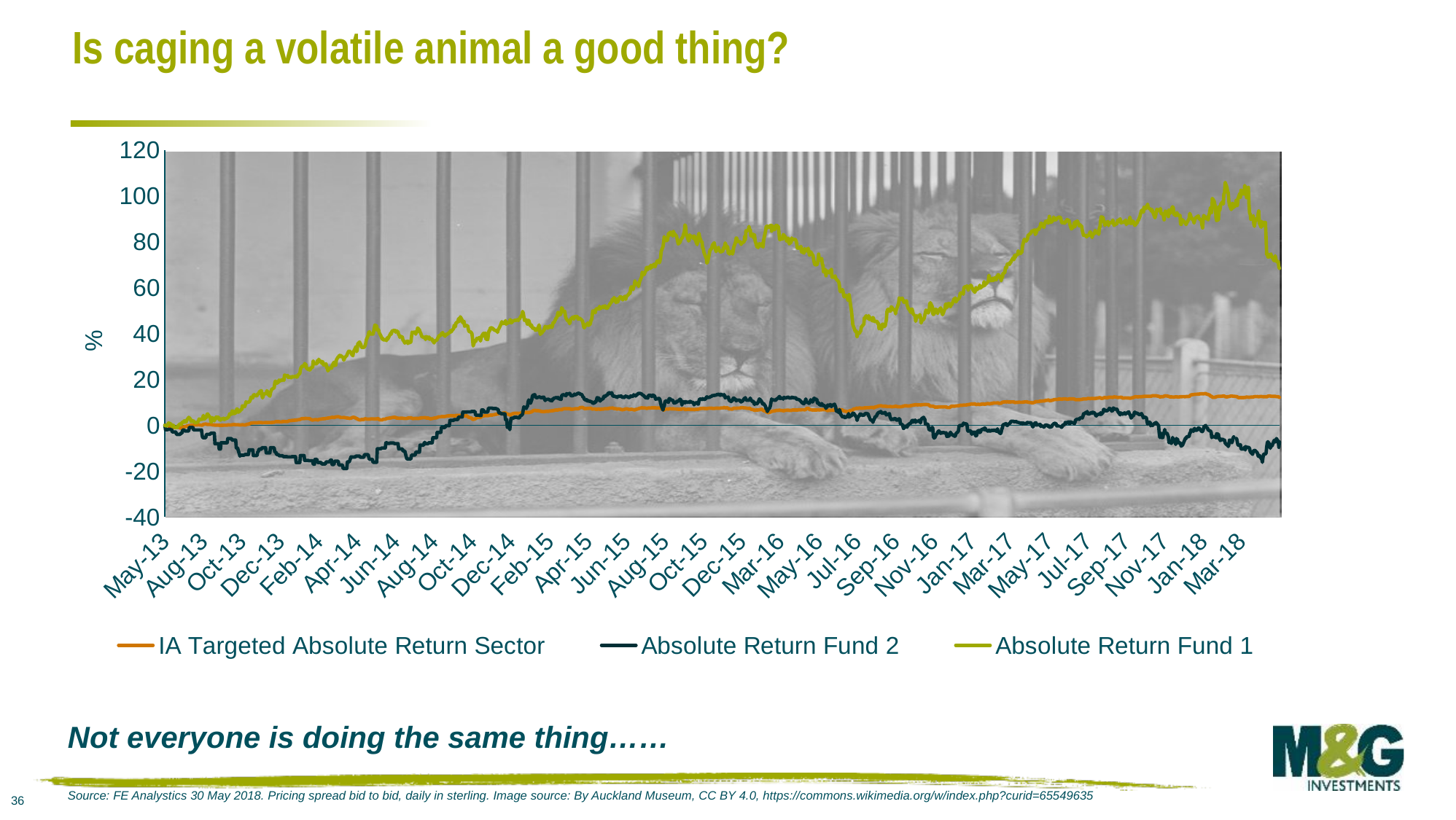
Is the value for Absolute Return Fund 1 around Jul-16 greater or less than 80? less Is the value for IA Targeted Absolute Return Sector at Mar-18 greater or less than 20? less At Mar-18, which is higher: Absolute Return Fund 1 or Absolute Return Fund 2? Absolute Return Fund 1 Is the highest value reached by Absolute Return Fund 1 greater or less than 80? greater How many series does the chart's legend list? 3 Which series reaches the highest value on the chart? Absolute Return Fund 1 What kind of chart is shown on the slide? line chart Which series reaches the lowest value on the chart? Absolute Return Fund 2 Does the IA Targeted Absolute Return Sector line generally rise or fall from May-13 to Mar-18? rise What are the three series named in the chart's legend? IA Targeted Absolute Return Sector, Absolute Return Fund 2, Absolute Return Fund 1 What is the label on the chart's vertical axis? %